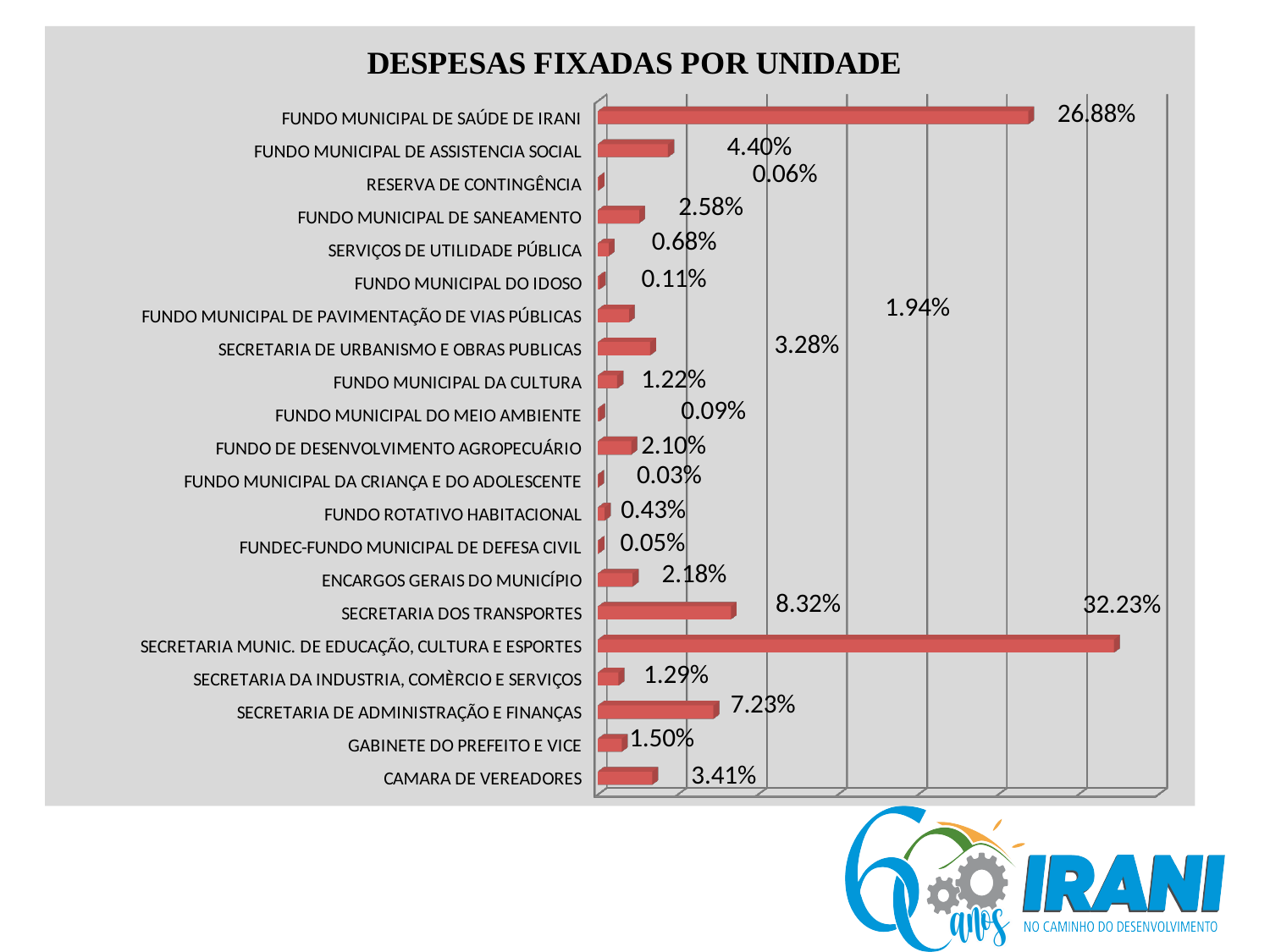
Which category has the highest value? SECRETARIA MUNIC. DE EDUCAÇÃO, CULTURA E ESPORTES What kind of chart is shown on the slide? Bar chart What is the difference between the values for SECRETARIA DOS TRANSPORTES and SECRETARIA DE ADMINISTRAÇÃO E FINANÇAS? 1.09% How many categories are shown in the chart? 21 What is the value for FUNDO MUNICIPAL DE SAÚDE DE IRANI? 26.88% What is the value for SECRETARIA DE ADMINISTRAÇÃO E FINANÇAS? 7.23% Which category has the lowest value? FUNDO MUNICIPAL DA CRIANÇA E DO ADOLESCENTE What is the difference between the values for SECRETARIA MUNIC. DE EDUCAÇÃO, CULTURA E ESPORTES and FUNDO MUNICIPAL DE SAÚDE DE IRANI? 5.35% What is the value for SECRETARIA DOS TRANSPORTES? 8.32% What is the title of the chart? DESPESAS FIXADAS POR UNIDADE Which is larger, the value for FUNDO MUNICIPAL DE ASSISTENCIA SOCIAL or the value for CAMARA DE VEREADORES? FUNDO MUNICIPAL DE ASSISTENCIA SOCIAL What is the value for CAMARA DE VEREADORES? 3.41%